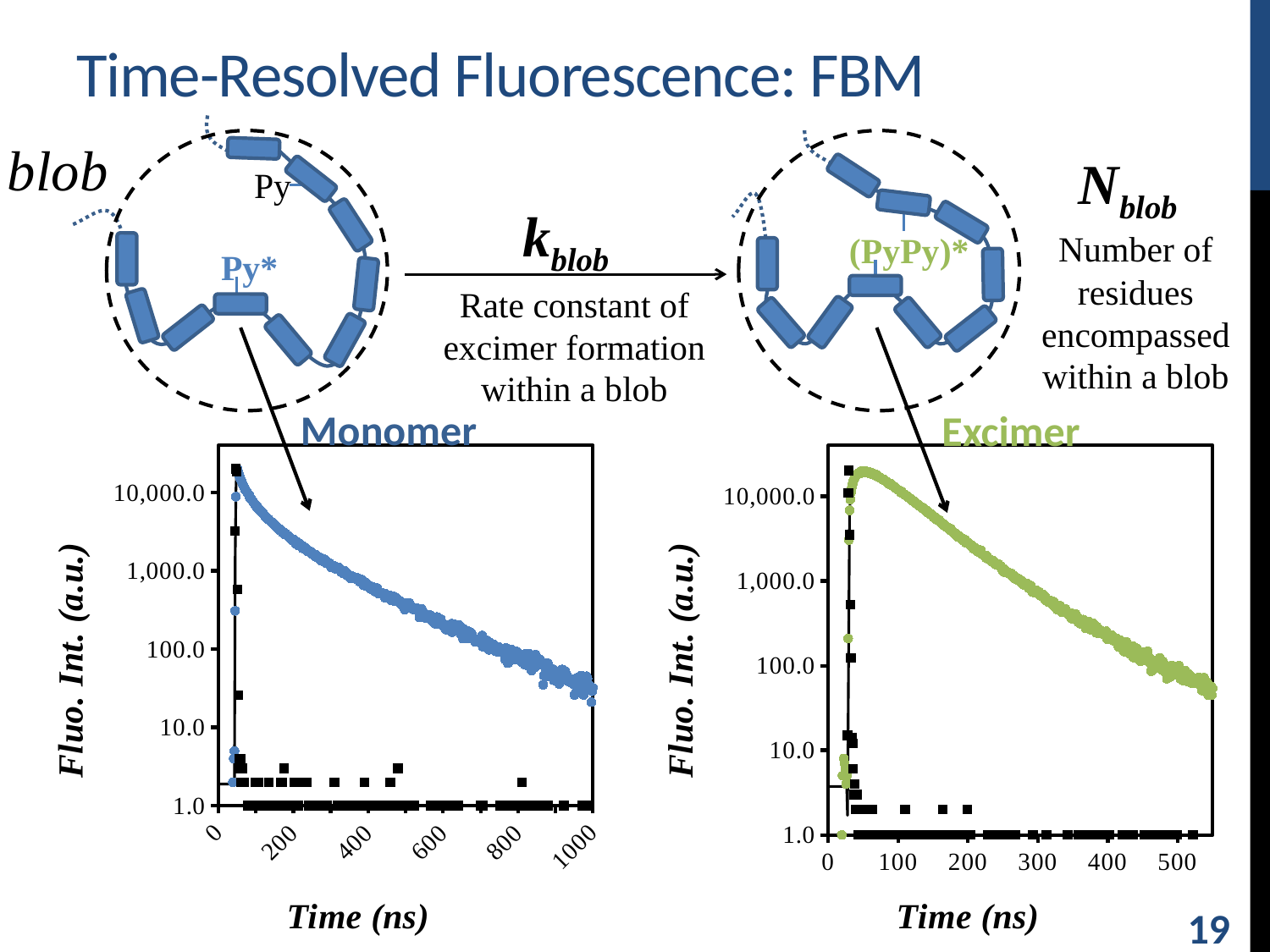
In the Monomer chart, is the blue fluorescence intensity at 200 ns greater or less than 1,000.0? greater What kind of chart is the Monomer chart? scatter chart In the Excimer chart, is the green fluorescence intensity at 500 ns greater or less than 100.0? less What is the label of the y-axis on the Monomer chart? Fluo. Int. (a.u.) In the Excimer chart, is the green fluorescence intensity at 300 ns greater or less than 100.0? greater In the Excimer chart, do the green fluorescence intensity values rise or fall as time increases beyond 100 ns? fall How many charts are shown on the slide? 2 In the Monomer chart, do the blue fluorescence intensity values rise or fall as time increases after the initial peak? fall What kind of chart is the Excimer chart? scatter chart What is the maximum tick value on the x-axis of the Excimer chart? 500